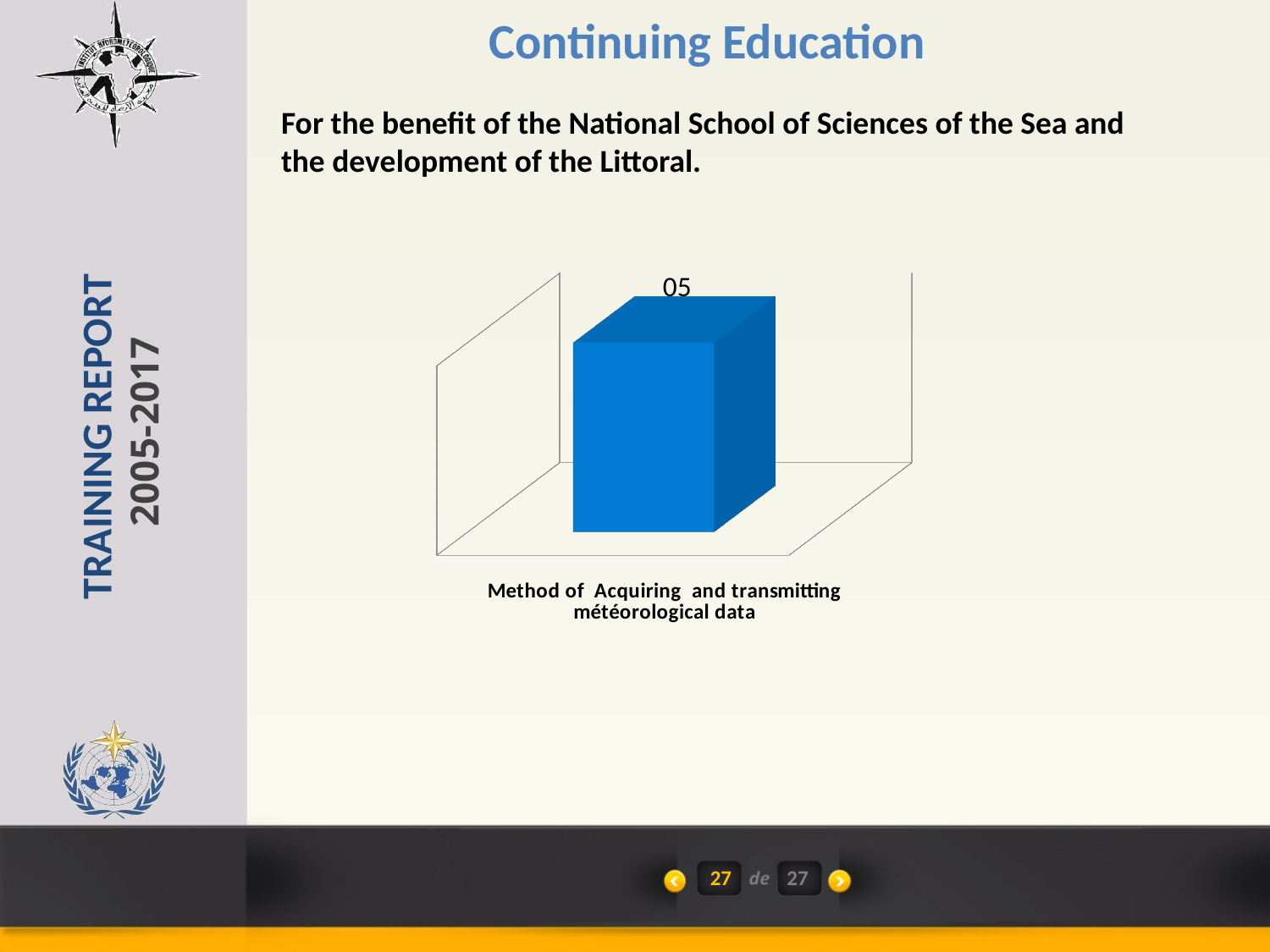
How many bars are plotted in the chart? 1 What kind of chart is shown on the slide? bar chart What value is shown on the bar for "Method of Acquiring and transmitting météorological data"? 05 What is the category label shown beneath the bar? Method of Acquiring and transmitting météorological data What colour is the bar in the chart? blue Which category has the highest value in the chart? Method of Acquiring and transmitting météorological data